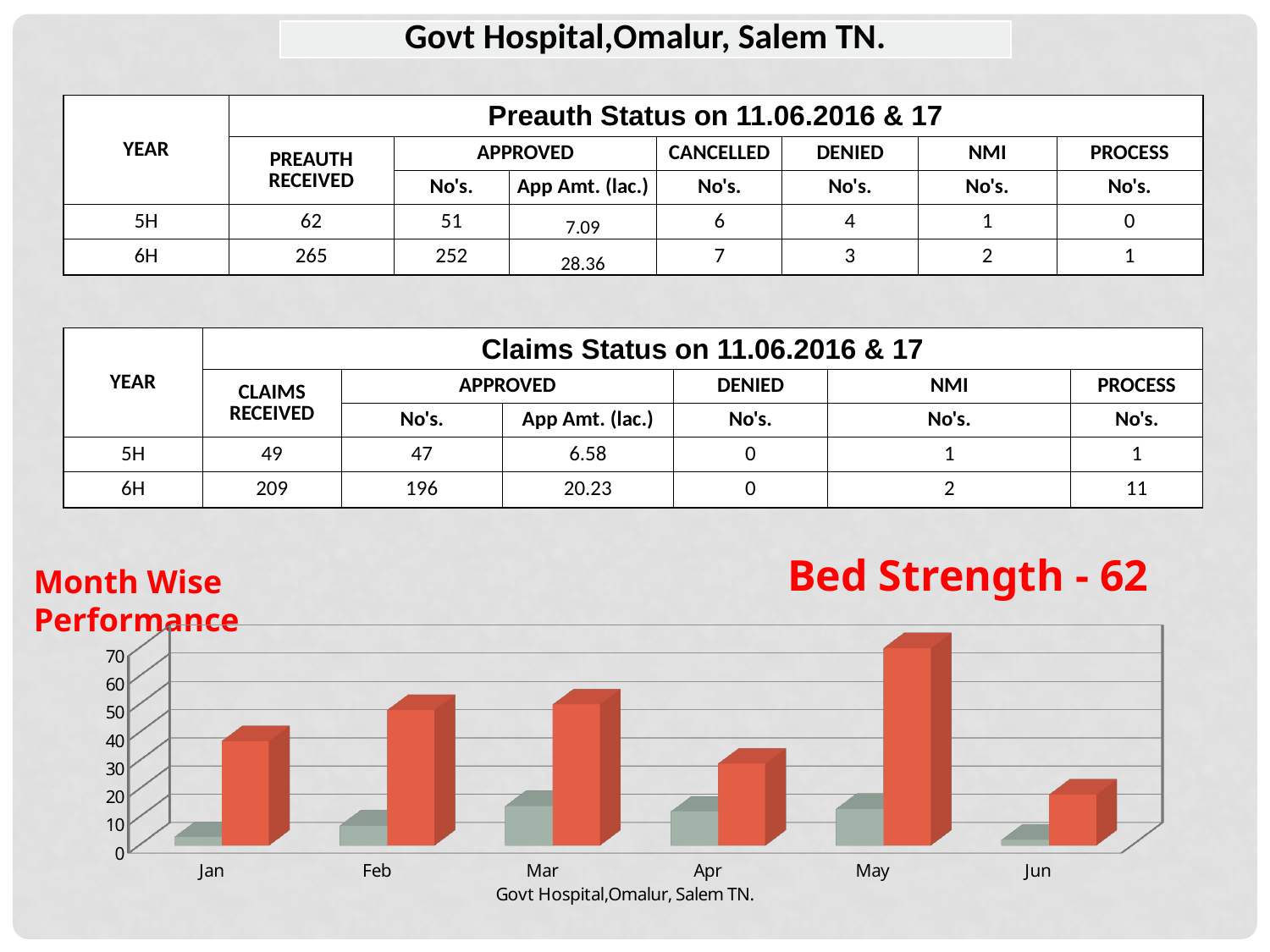
Is the red bar for May greater or less than 60? greater Is the green bar for Jan greater or less than 10? less Do the red bars rise or fall from May to Jun? fall Is the red bar for Jan greater or less than 30? greater How many months are shown on the x axis of the bar chart? 6 What kind of chart is shown at the bottom of the slide? bar chart What is the title shown above the bar chart? Month Wise Performance Which is larger, the red bar for Apr or the red bar for Jun? Apr Which month has the tallest red bar in the bar chart? May What text appears below the x axis of the bar chart? Govt Hospital,Omalur, Salem TN. Which month has the shortest red bar in the bar chart? Jun